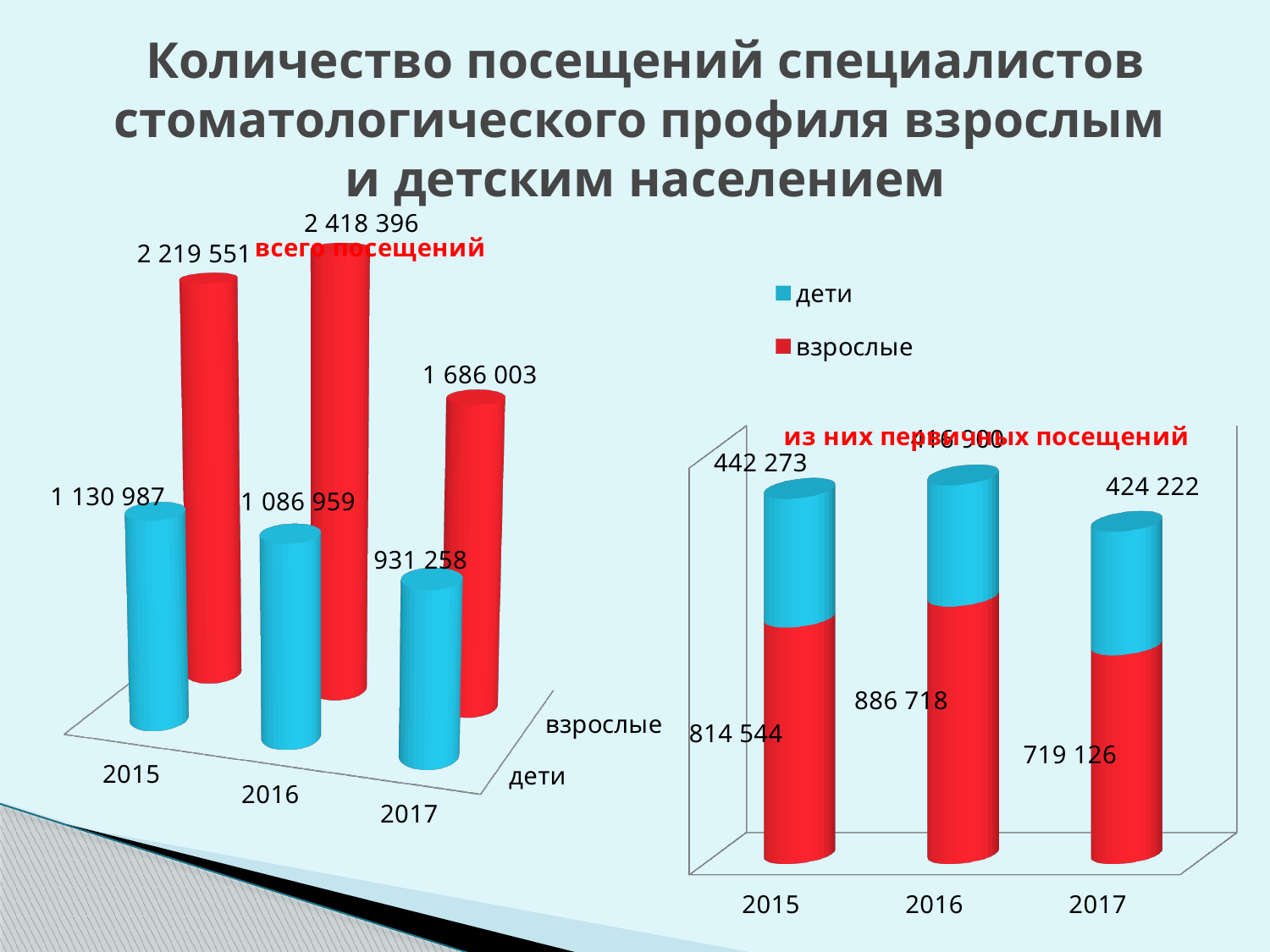
On the left chart (всего посещений), what is the value for взрослые in 2016? 2 418 396 On the left chart (всего посещений), what is the value for дети in 2015? 1 130 987 On the left chart (всего посещений), what is the difference between взрослые and дети in 2015? 1 088 564 On the left chart (всего посещений), in which year is the value for взрослые highest? 2016 On the left chart (всего посещений), what is the value for дети in 2017? 931 258 How many series does the legend on the right chart list? 2 On the right chart (из них первичных посещений), what is the value for дети in 2017? 424 222 On the left chart (всего посещений), in which year is the value for дети lowest? 2017 On the right chart (из них первичных посещений), which is larger in 2017: взрослые or дети? взрослые On the right chart (из них первичных посещений), what is the value for взрослые in 2016? 886 718 On the left chart (всего посещений), do the values for дети rise or fall from 2015 to 2017? fall On the right chart (из них первичных посещений), what is the total of the stacked bar for 2015? 1 256 817